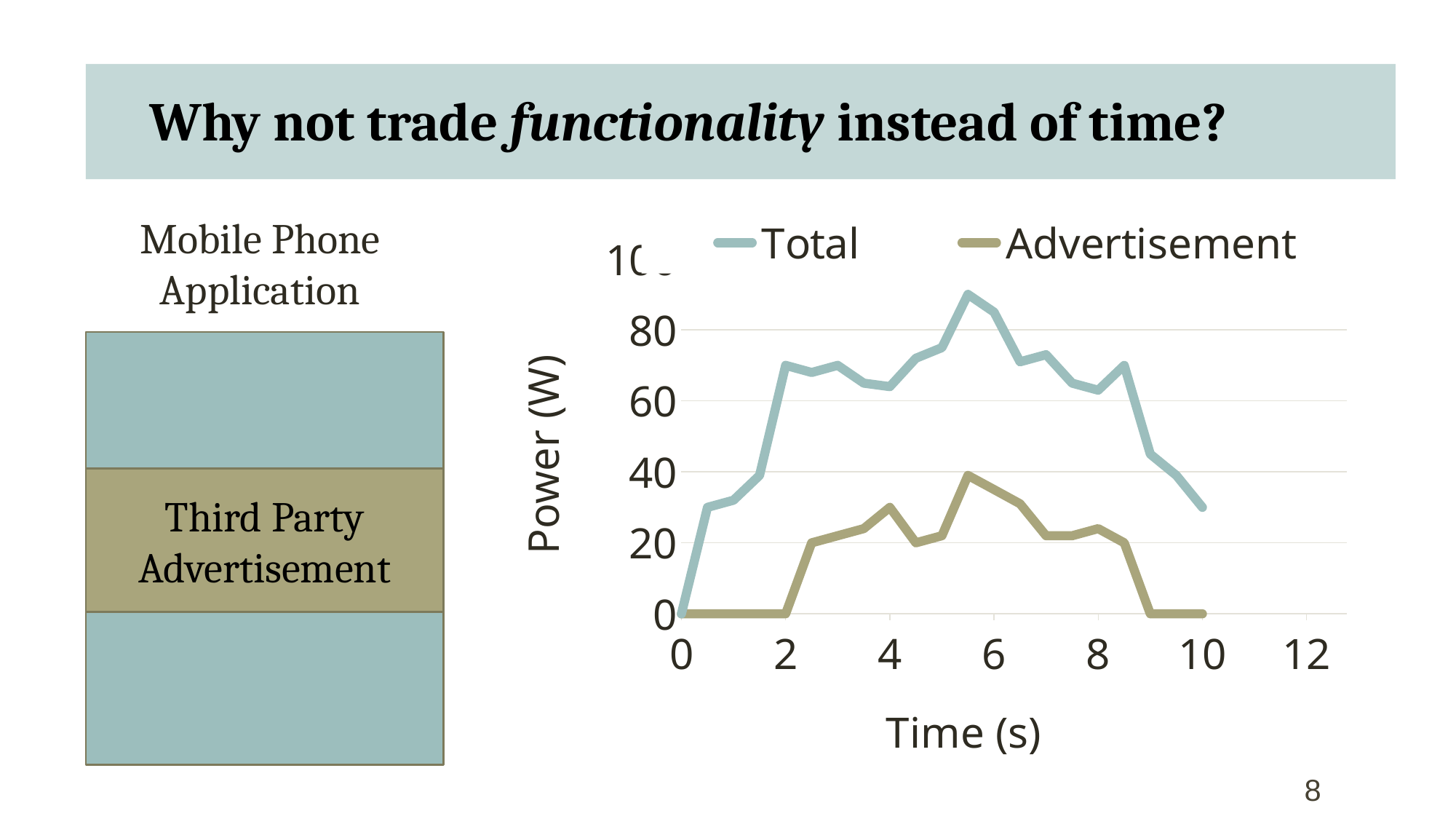
What is the label of the chart's vertical axis? Power (W) How many series does the chart legend list? 2 What is the value of the Advertisement series at time 10 s? 0 What is the value of the Advertisement series at time 1 s? 0 Is the peak value of the Total series greater or less than 80? greater What kind of chart is shown on the slide? line chart Is the value of the Advertisement series at time 4 s greater or less than 20? greater At time 6 s, which series has the higher value, Total or Advertisement? Total Is the value of the Total series at time 10 s greater or less than 40? less Does the Total series rise or fall between time 8.5 s and 10 s? fall What are the two series named in the chart legend? Total and Advertisement